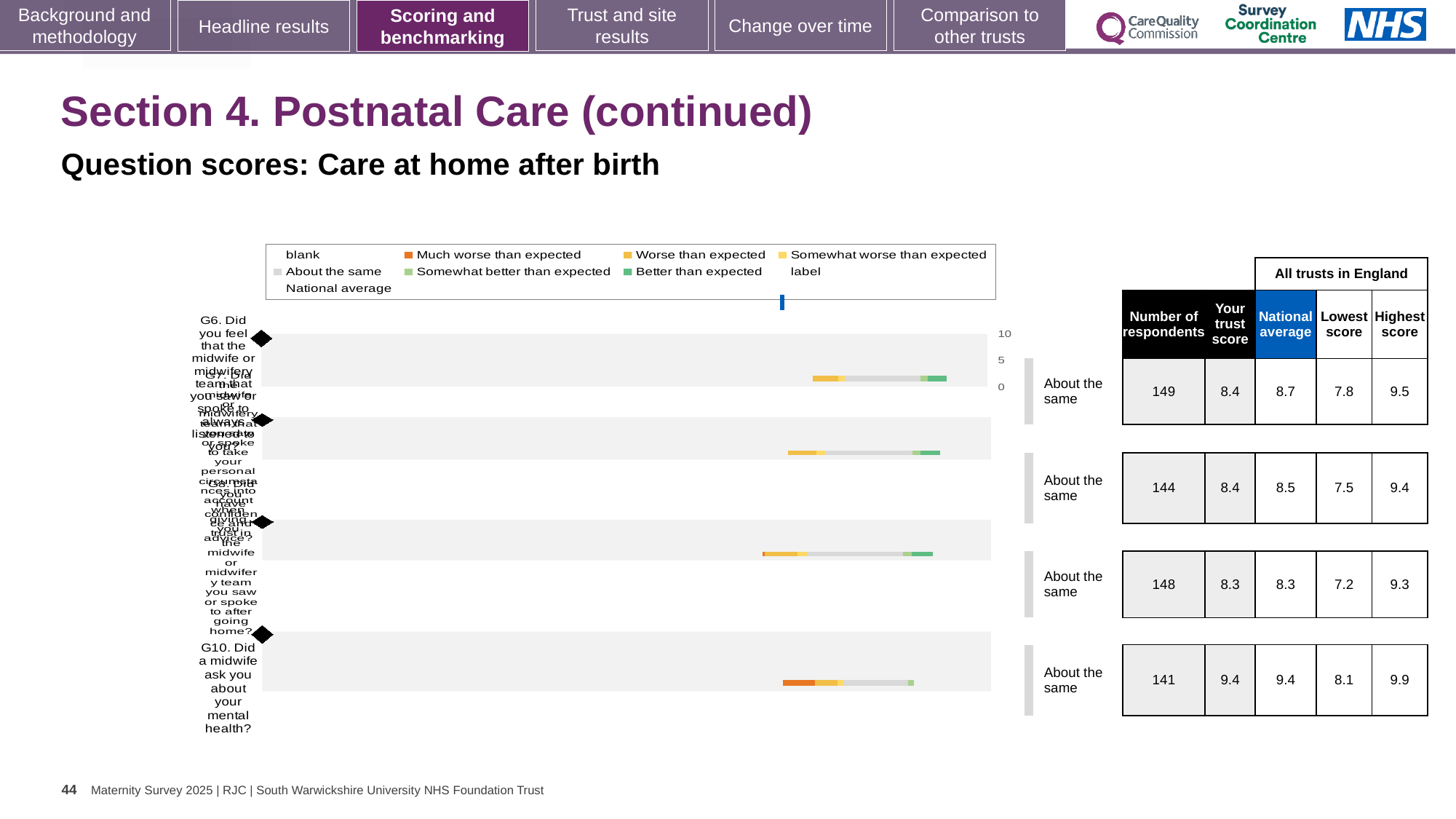
What benchmark category is shown next to each of the four questions? About the same How many questions (bars) are plotted in the chart? 4 What is the smallest value shown in the Lowest score column? 7.2 What is the number of respondents for G10? 141 What is the trust score for G6? 8.4 What kind of chart is shown on the slide? bar chart What is the number of respondents for G6 (Did you feel that the midwife or midwifery team listened to you)? 149 What is the national average for G10 (Did a midwife ask you about your mental health)? 9.4 What is the difference between the national average and the trust score for G6? 0.3 Which has the larger trust score, G6 or G10? G10 Which question has the highest trust score? G10 What is the highest score across all trusts in England for G10? 9.9